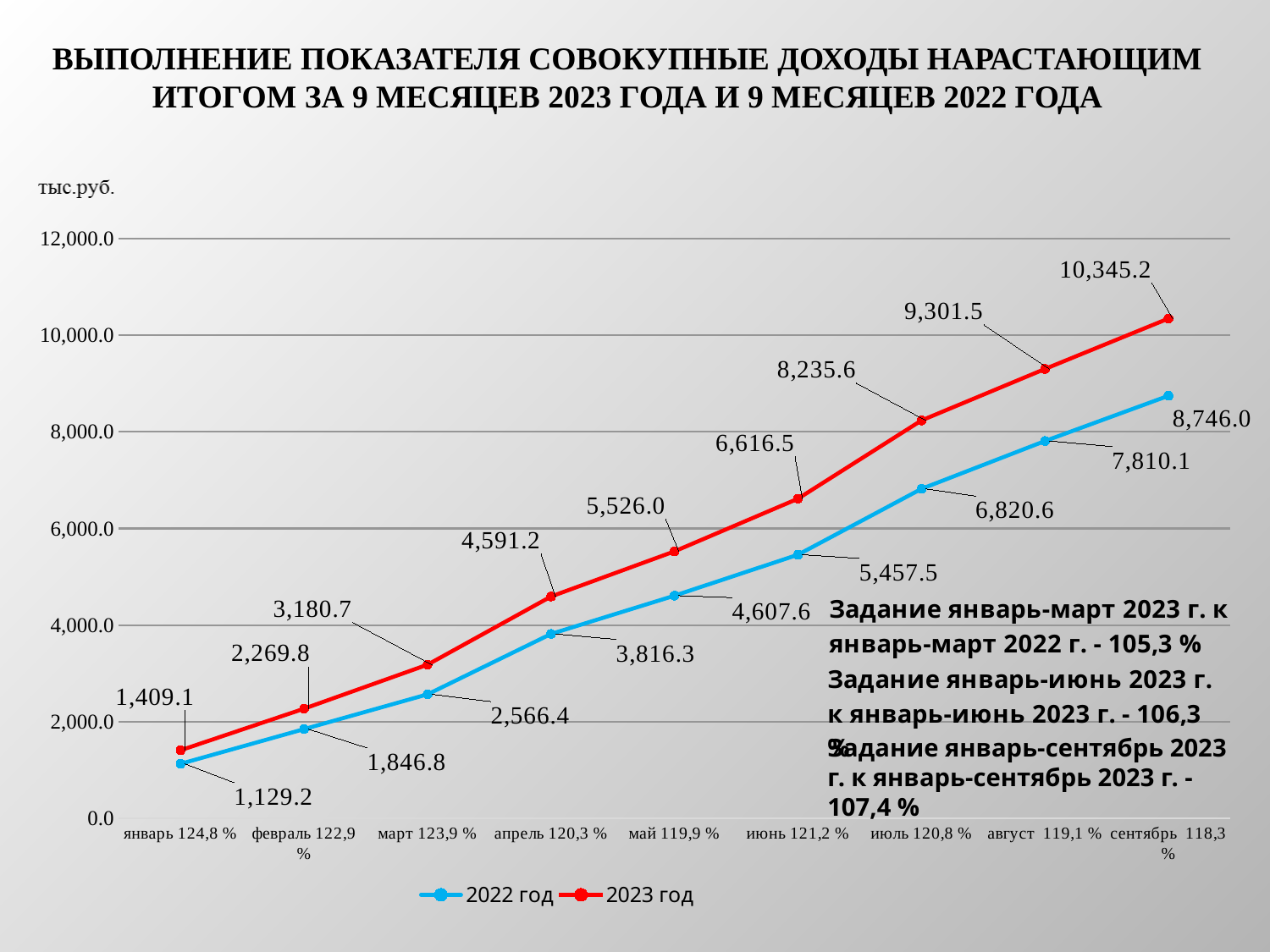
How many months are plotted on the x axis? 9 What is the value for 2022 год in январь? 1,129.2 What is the value for 2023 год in июнь? 6,616.5 What kind of chart is shown on the slide? line chart Do the values of the 2022 год series rise or fall from январь to сентябрь? rise How many series does the legend list? 2 In which month is the 2022 год series lowest? январь What is the difference between the 2023 год and 2022 год values in сентябрь? 1,599.2 What is the value for 2022 год in июль? 6,820.6 Which is larger in март: the 2023 год value or the 2022 год value? 2023 год In which month is the 2023 год series highest? сентябрь What is the value for 2023 год in сентябрь? 10,345.2